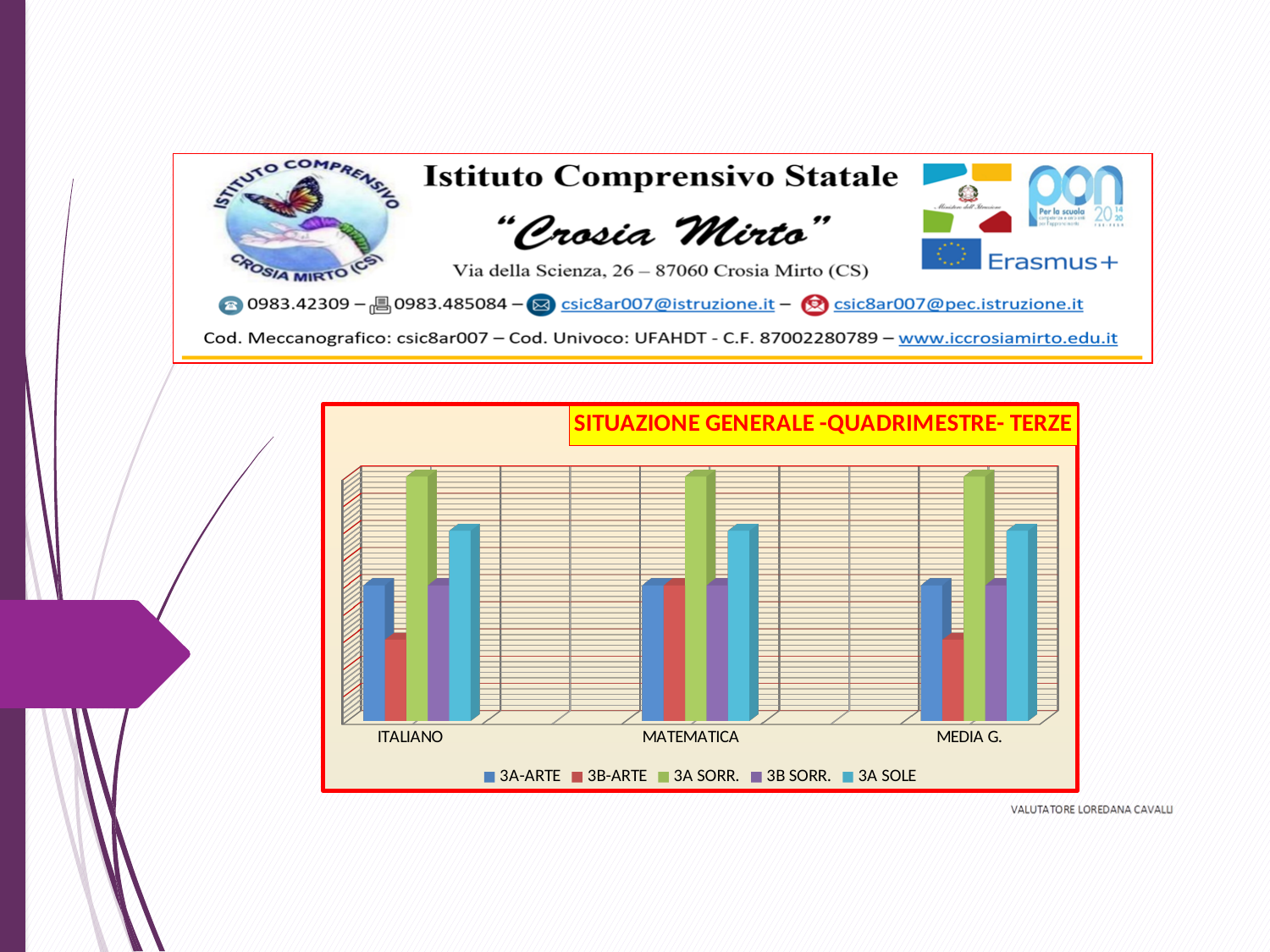
Which colour represents the 3A SORR. series in the chart's legend? green How many series does the chart's legend list? 5 What is the title of the chart? SITUAZIONE GENERALE -QUADRIMESTRE- TERZE Which series has the lowest value for MEDIA G.? 3B-ARTE For MEDIA G., which is larger: the value for 3A SORR. or the value for 3A SOLE? 3A SORR. Which series has the highest value for MEDIA G.? 3A SORR. For ITALIANO, which is larger: the value for 3A SOLE or the value for 3B-ARTE? 3A SOLE How many categories are shown on the x axis of the chart? 3 Which series has the highest value for MATEMATICA? 3A SORR. What kind of chart is shown on the slide? bar chart Which series has the lowest value for ITALIANO? 3B-ARTE Which series has the highest value for ITALIANO? 3A SORR.